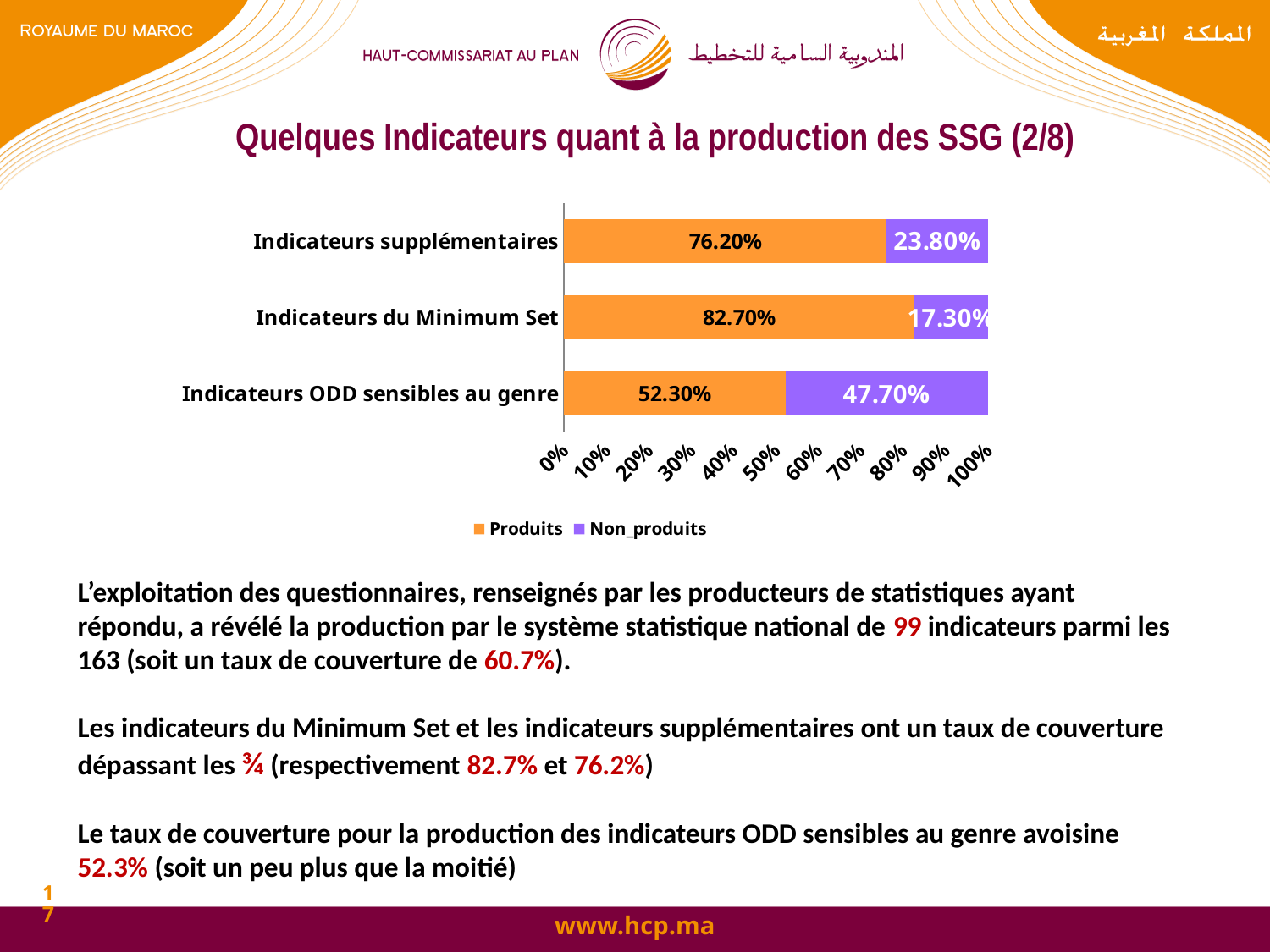
Which is larger: the 'Non_produits' value for 'Indicateurs supplémentaires' or for 'Indicateurs du Minimum Set'? Indicateurs supplémentaires What is the 'Non_produits' value for 'Indicateurs ODD sensibles au genre'? 47.70% What is the 'Produits' value for 'Indicateurs ODD sensibles au genre'? 52.30% Which category has the lowest 'Produits' value? Indicateurs ODD sensibles au genre Which category has the highest 'Produits' value? Indicateurs du Minimum Set What is the total of the stacked bar for 'Indicateurs ODD sensibles au genre'? 100.00% How many categories are shown on the chart? 3 What is the 'Non_produits' value for 'Indicateurs du Minimum Set'? 17.30% What kind of chart is shown on the slide? Stacked bar chart What is the difference between the 'Produits' values for 'Indicateurs du Minimum Set' and 'Indicateurs supplémentaires'? 6.50% How many series does the legend list? 2 What is the 'Produits' value for 'Indicateurs supplémentaires'? 76.20%